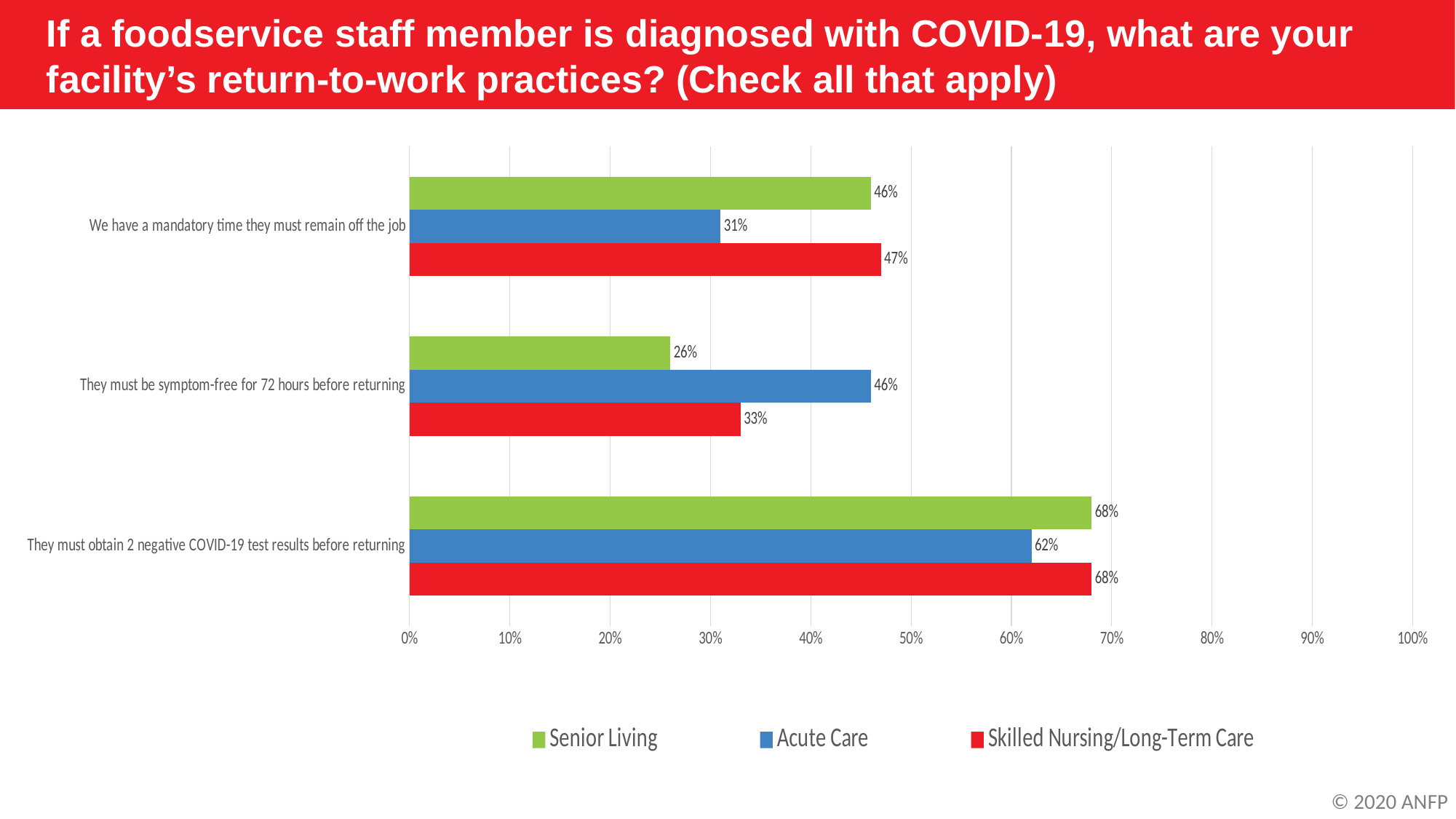
How many series does the legend list? 3 What is the Senior Living value for 'They must be symptom-free for 72 hours before returning'? 26% How many return-to-work practices are shown on the chart? 3 What percentage of Acute Care respondents said they must obtain 2 negative COVID-19 test results before returning? 62% Which return-to-work practice has the lowest value for Acute Care? We have a mandatory time they must remain off the job For 'We have a mandatory time they must remain off the job', which is larger: the Senior Living value or the Acute Care value? Senior Living What kind of chart is shown on the slide? Bar chart What is the difference between the Acute Care and Senior Living values for 'They must be symptom-free for 72 hours before returning'? 20% Which return-to-work practice has the highest value for Senior Living? They must obtain 2 negative COVID-19 test results before returning Which colour represents Acute Care in the chart? Blue Is the Skilled Nursing/Long-Term Care value for 'They must obtain 2 negative COVID-19 test results before returning' greater or less than 60%? greater What is the Skilled Nursing/Long-Term Care value for 'We have a mandatory time they must remain off the job'? 47%